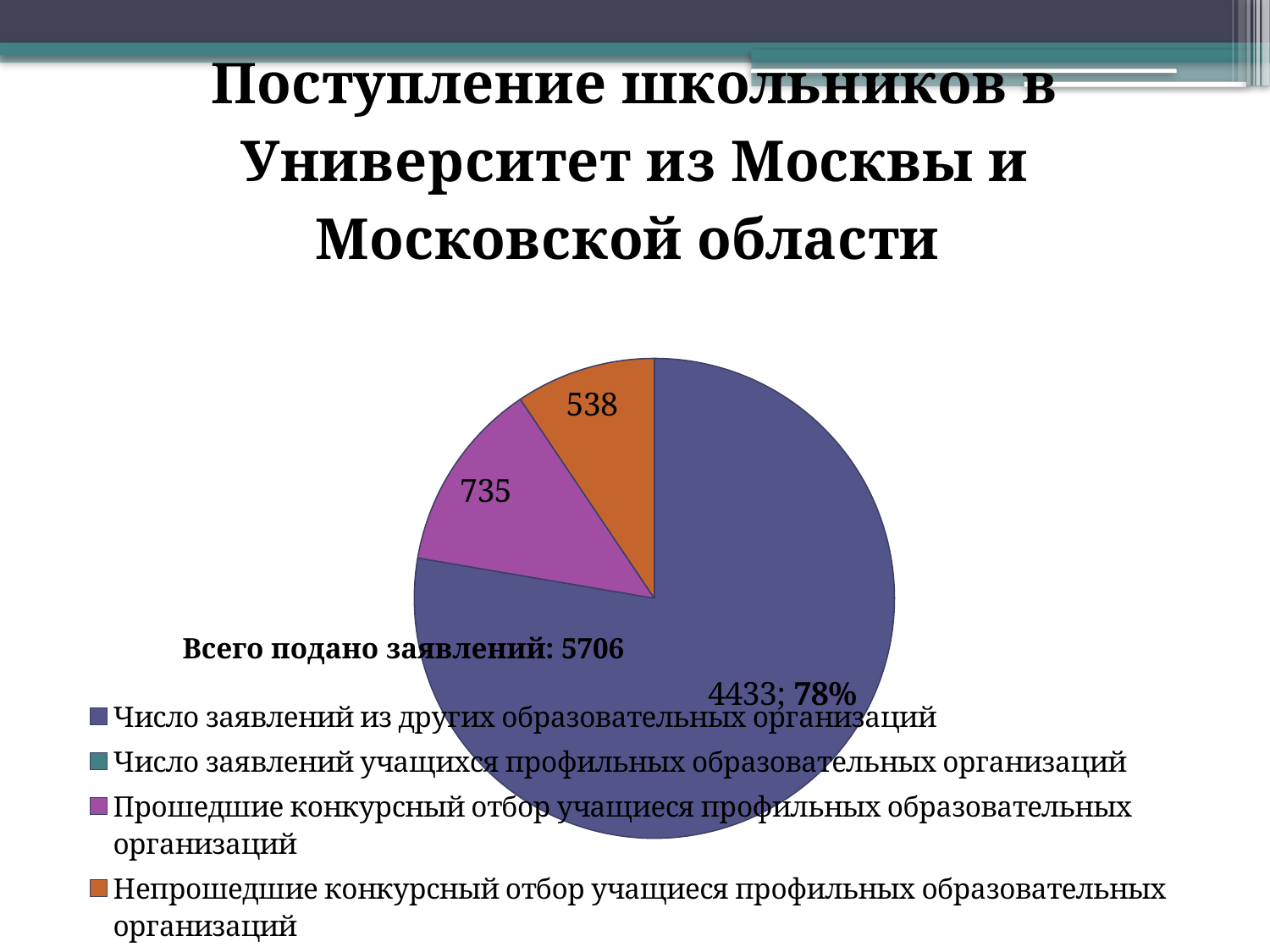
Which category has the largest slice of the pie? Число заявлений из других образовательных организаций What is the value for "Непрошедшие конкурсный отбор учащиеся профильных образовательных организаций"? 538 What is the value for "Прошедшие конкурсный отбор учащиеся профильных образовательных организаций"? 735 Which labelled slice of the pie is the smallest? Непрошедшие конкурсный отбор учащиеся профильных образовательных организаций Which is larger: the slice for "Прошедшие конкурсный отбор" or the slice for "Непрошедшие конкурсный отбор"? Прошедшие конкурсный отбор What is the difference between the values for "Прошедшие конкурсный отбор" (735) and "Непрошедшие конкурсный отбор" (538)? 197 What is the value for "Число заявлений из других образовательных организаций"? 4433 What type of chart is shown on the slide? pie chart What share of the pie does the slice for "Число заявлений из других образовательных организаций" represent? 78% How many entries does the legend list? 4 How many slices with data labels are visible in the pie chart? 3 What total number of applications is stated on the slide ("Всего подано заявлений")? 5706